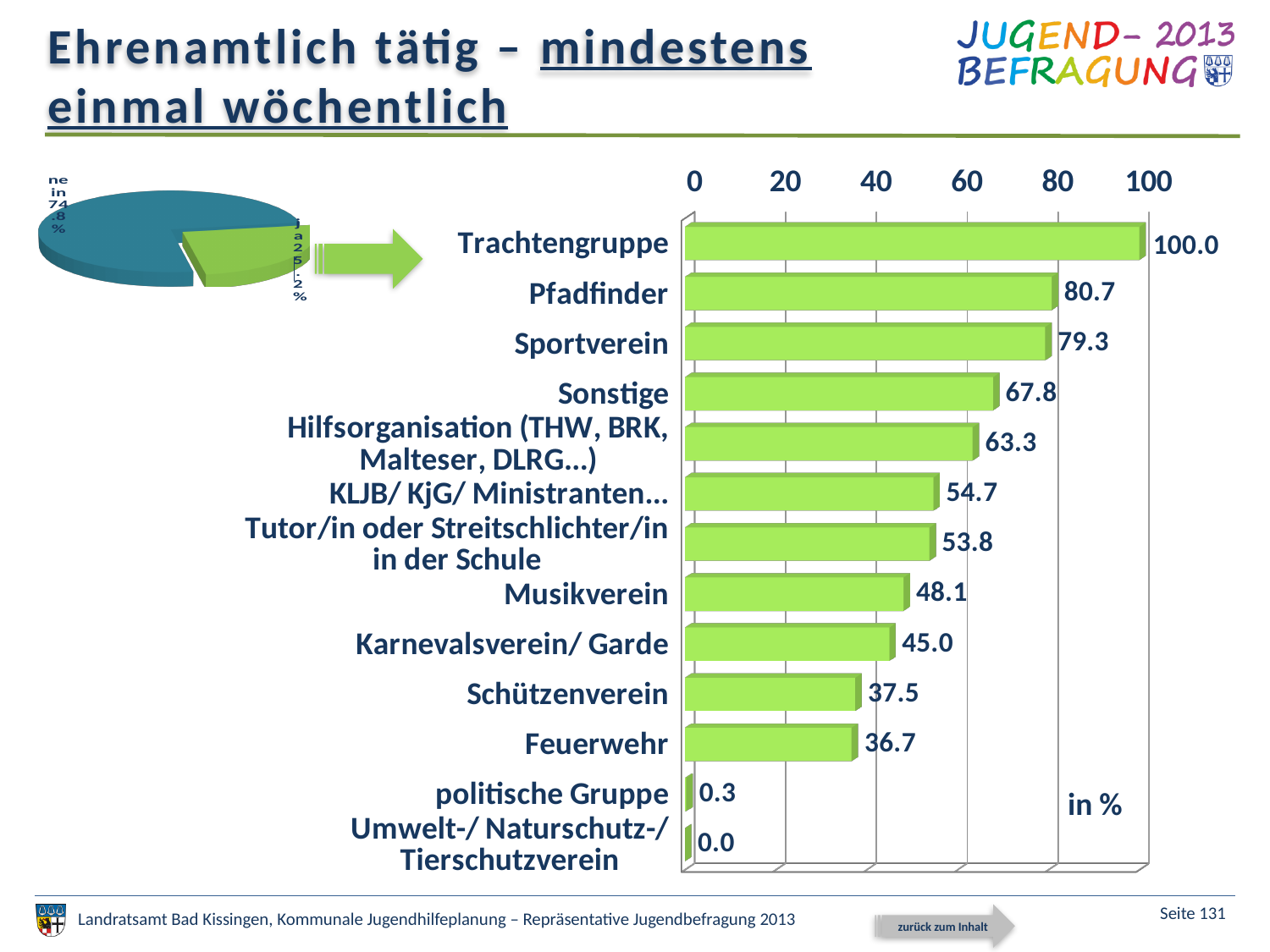
In the bar chart, what is the difference between the values for Sportverein and Schützenverein? 41.8 How many categories does the bar chart show? 13 In the bar chart, what is the value for Feuerwehr? 36.7 In the bar chart, which is larger: the value for Hilfsorganisation (THW, BRK, Malteser, DLRG...) or the value for KLJB/ KjG/ Ministranten...? Hilfsorganisation (THW, BRK, Malteser, DLRG...) In the bar chart, which category has the highest value? Trachtengruppe In the bar chart, which category has the lowest value? Umwelt-/ Naturschutz-/ Tierschutzverein What kind of chart is the small chart in the top left of the slide? pie chart What kind of chart is the large chart on the right of the slide? bar chart In the bar chart, what is the value for Musikverein? 48.1 In the bar chart, what is the difference between the values for Sonstige and Karnevalsverein/ Garde? 22.8 In the bar chart, is the value for Tutor/in oder Streitschlichter/in in der Schule greater or less than 60? less In the bar chart, what is the value for Pfadfinder? 80.7